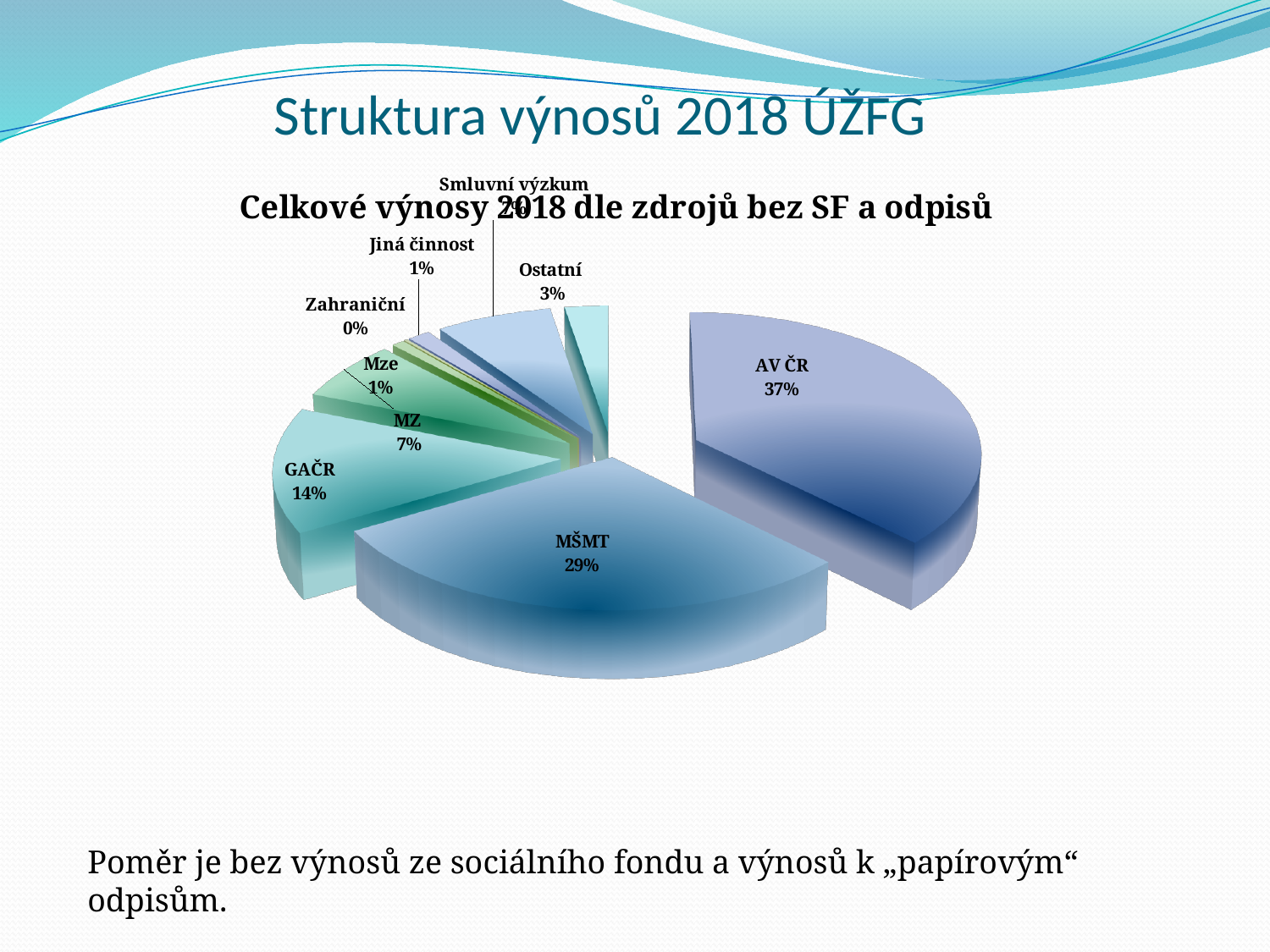
What is the difference between the shares of AV ČR and MŠMT? 8% Which category has the largest share of the pie? AV ČR Which is larger, the share of GAČR or the share of MZ? GAČR Which category has the smallest share of the pie? Zahraniční What is the value shown for Ostatní? 3% What share of the pie does MŠMT represent? 29% What is the value shown for Zahraniční? 0% What is the title of the chart? Celkové výnosy 2018 dle zdrojů bez SF a odpisů What share of the pie does GAČR represent? 14% What share of the pie does AV ČR represent? 37% What is the value shown for MZ? 7% What kind of chart is shown on the slide? pie chart